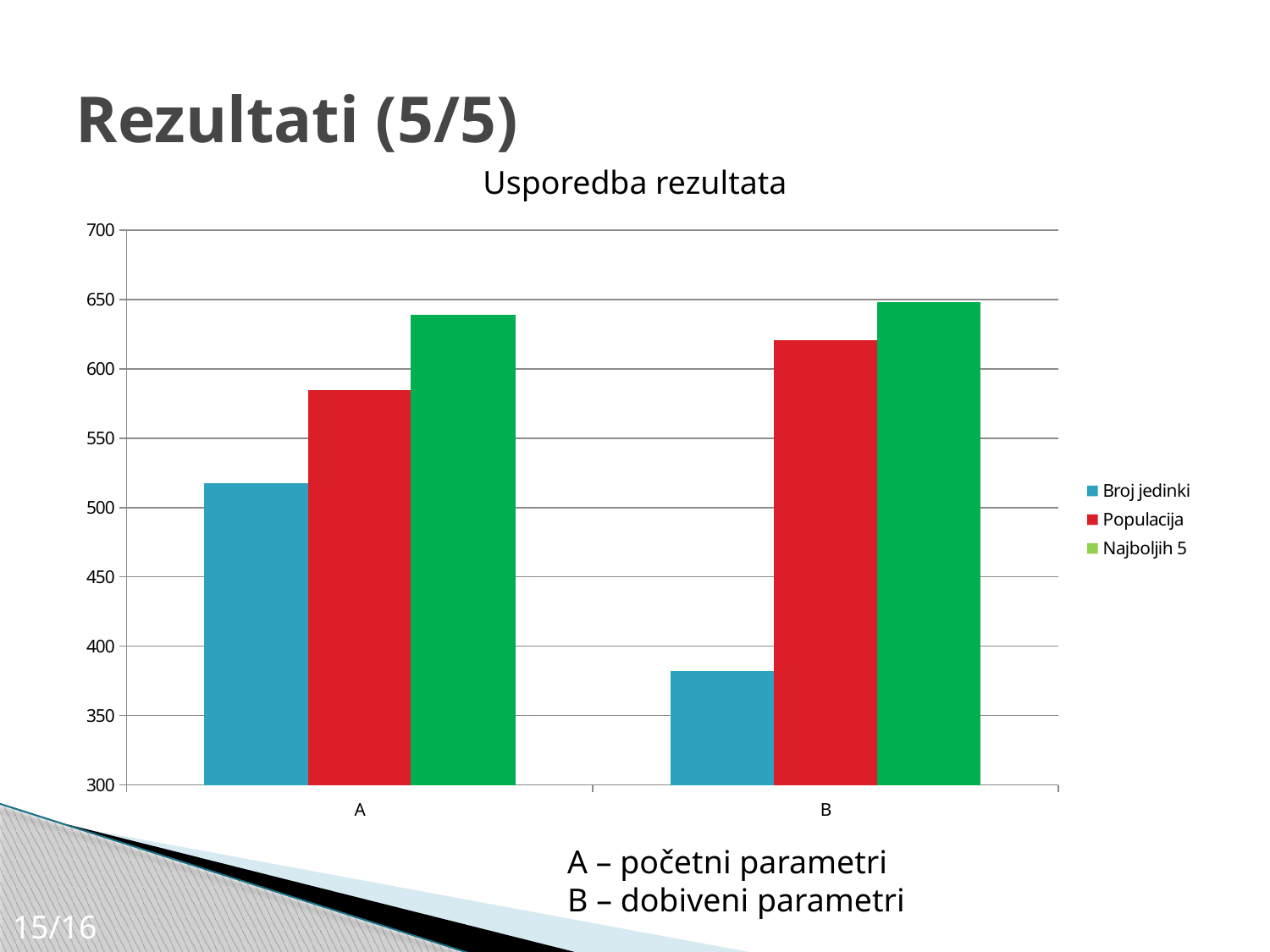
Is the value of Populacija for category B greater or less than 600? greater How many series does the legend list? 3 Which series has the lowest value for category B? Broj jedinki Which is larger, Broj jedinki for category A or Broj jedinki for category B? Broj jedinki for category A Which series has the highest value for category A? Najboljih 5 Is the value of Broj jedinki for category A greater or less than 500? greater What is the title of the chart? Usporedba rezultata How many categories are shown on the x axis? 2 Is the value of Najboljih 5 for category A greater or less than 650? less Which is larger, Populacija for category A or Populacija for category B? Populacija for category B What kind of chart is shown on the slide? bar chart